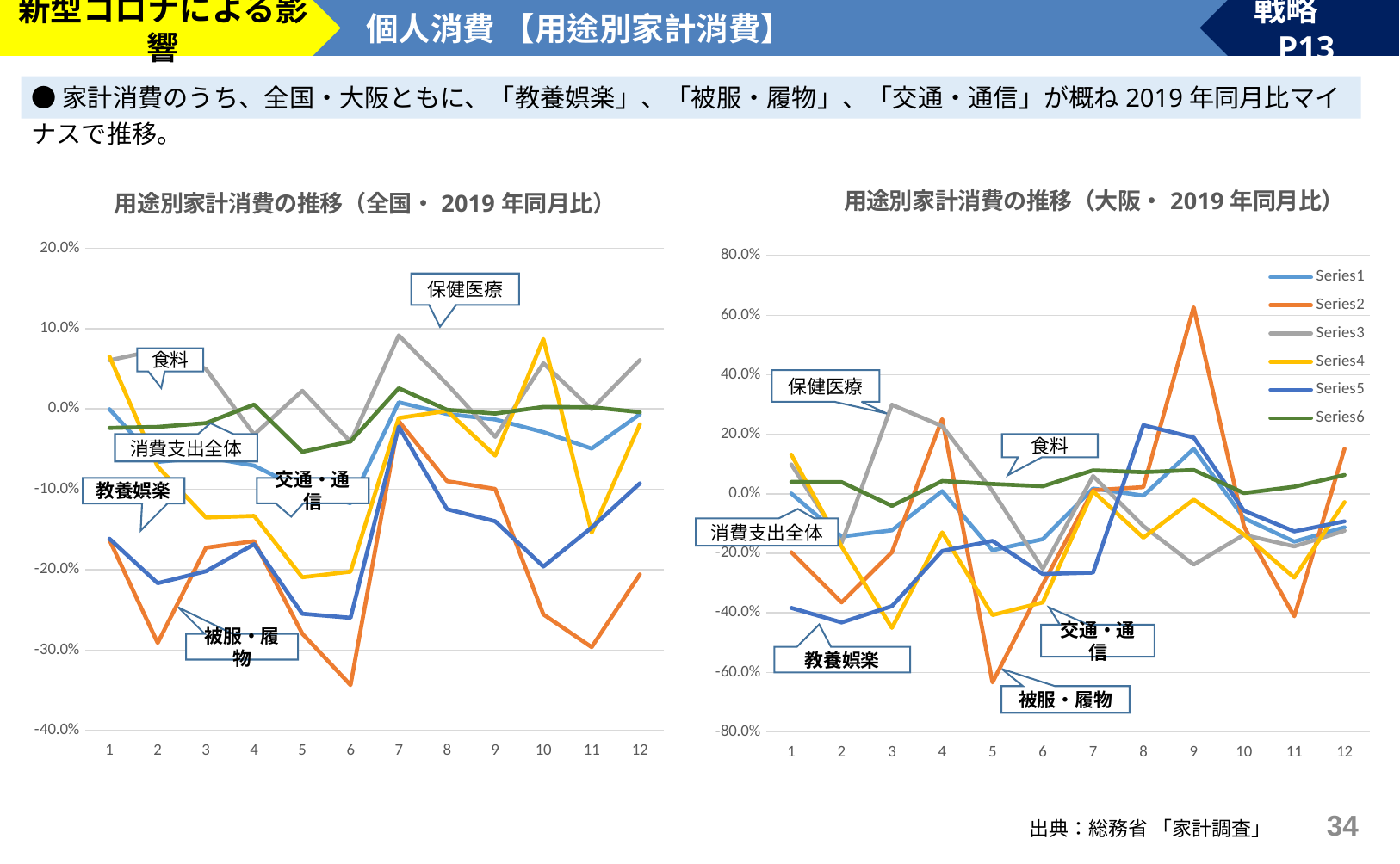
In the left chart (全国), is the value for 被服・履物 at month 6 greater or less than -30.0%? less In the right chart (大阪), is the value for 被服・履物 at month 9 greater or less than 40.0%? greater In the left chart (全国), what is the lowest value shown on the y axis? -40.0% In the right chart (大阪), is the value for 被服・履物 at month 5 greater or less than -40.0%? less In the right chart (大阪), at which month does the 被服・履物 line reach its highest value? 9 In the left chart (全国), at which month does the 被服・履物 line reach its lowest value? 6 How many points along the x axis does the left chart (全国) have? 12 In the right chart (大阪), what is the highest value shown on the y axis? 80.0% How many series does the legend of the right chart (大阪) list? 6 What kind of chart is the left chart titled 用途別家計消費の推移（全国・2019年同月比）? line chart